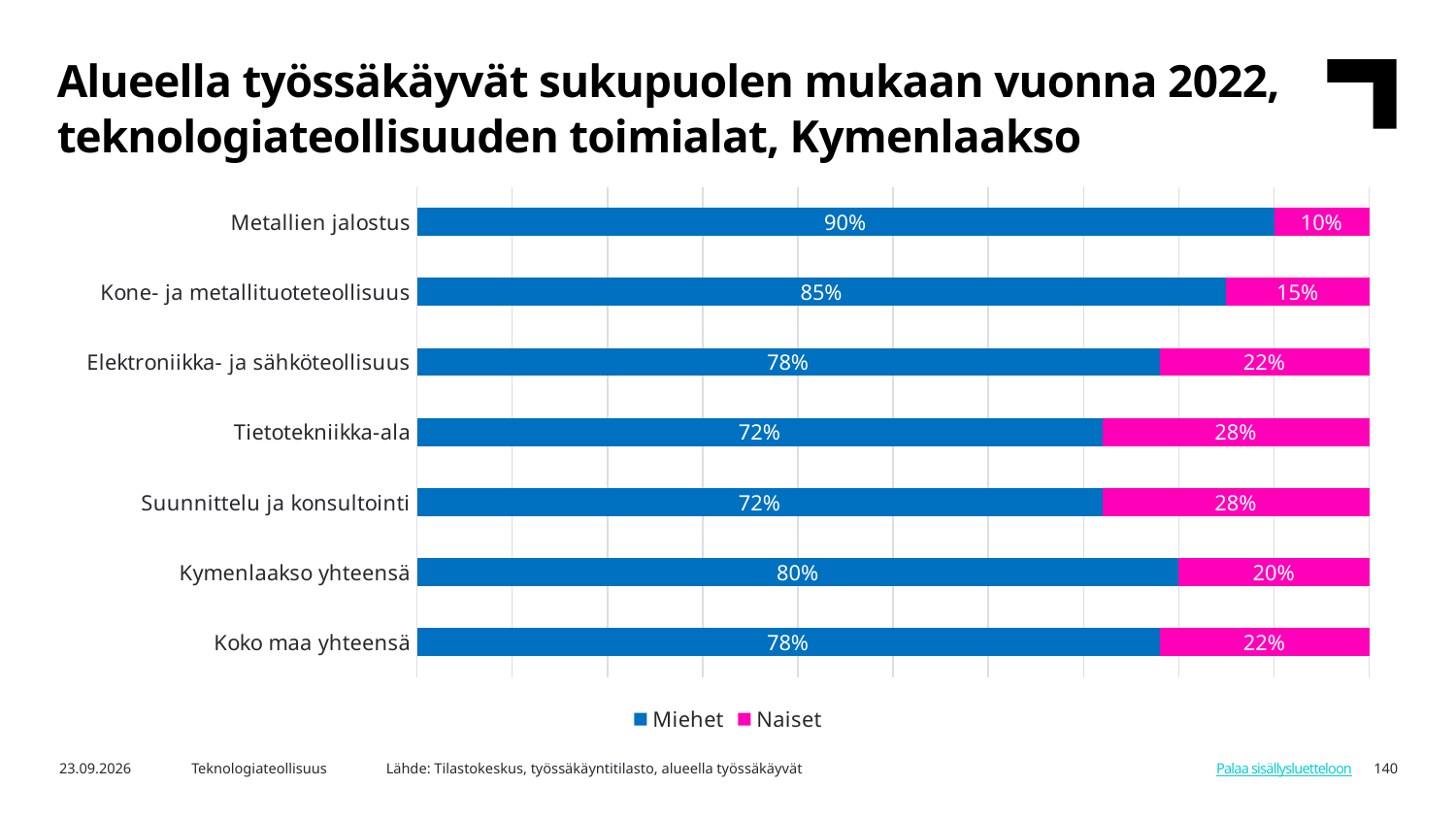
Which is larger: the Naiset share for Elektroniikka- ja sähköteollisuus or for Kone- ja metallituoteteollisuus? Elektroniikka- ja sähköteollisuus Which category has the highest Naiset share? Tietotekniikka-ala and Suunnittelu ja konsultointi What is the Naiset share for Tietotekniikka-ala? 28% What is the Miehet share for Metallien jalostus? 90% How many categories are shown on the chart? 7 Which category has the lowest Naiset share? Metallien jalostus What is the Naiset share for Kymenlaakso yhteensä? 20% What is the total of the stacked bar for Suunnittelu ja konsultointi? 100% What kind of chart is shown on the slide? Stacked bar chart How many series does the legend list? 2 What is the Miehet share for Koko maa yhteensä? 78% What is the difference between the Miehet share for Metallien jalostus and for Kone- ja metallituoteteollisuus? 5%